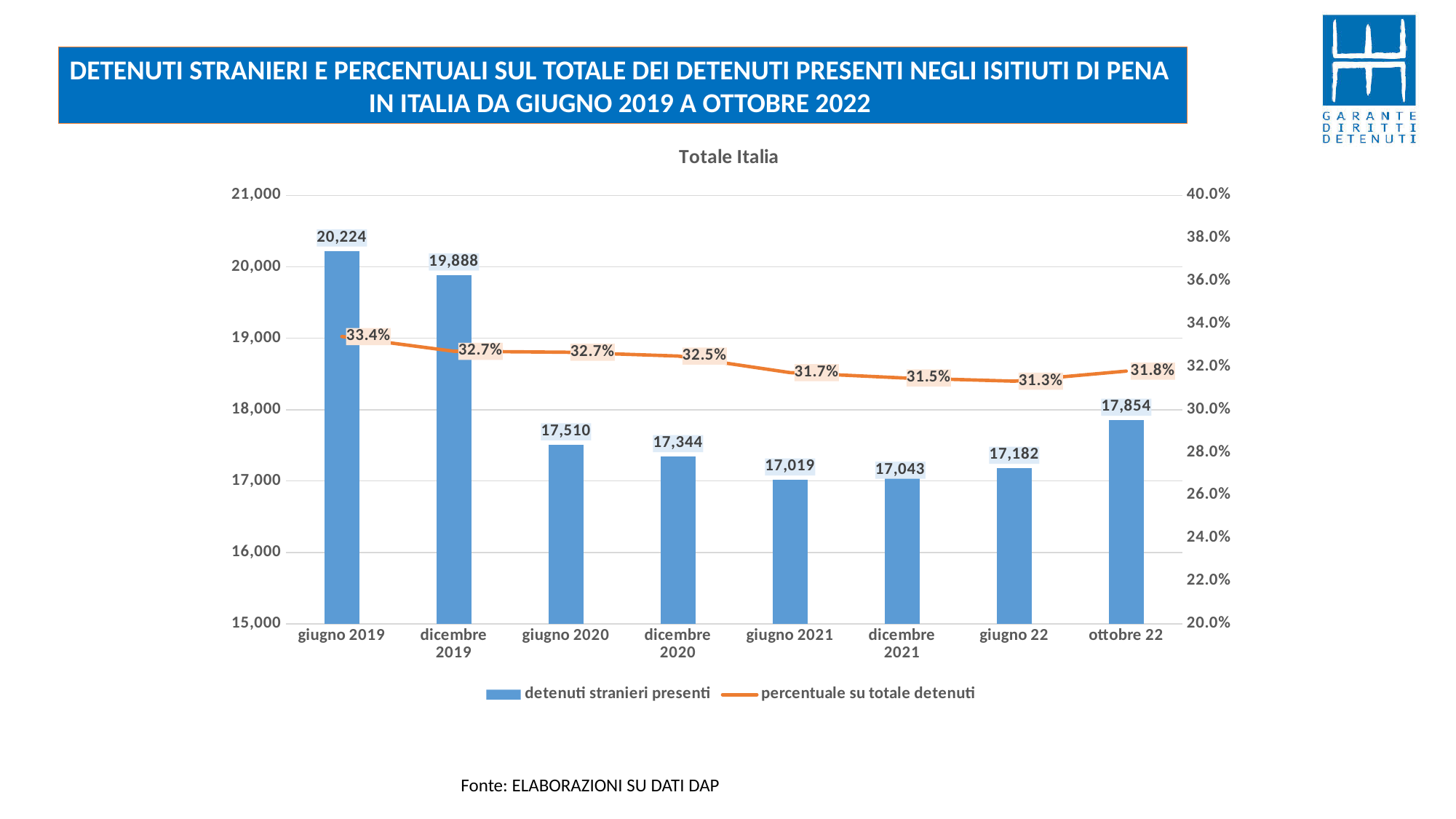
What is the value of 'detenuti stranieri presenti' for giugno 2019? 20,224 How many series does the legend list? 2 Which category has the lowest 'percentuale su totale detenuti'? giugno 22 What kind of chart is this? Combined bar and line chart Which category has the highest value of 'detenuti stranieri presenti'? giugno 2019 How many categories are shown on the x axis? 8 What is the value of 'detenuti stranieri presenti' for dicembre 2021? 17,043 Which is larger, the 'detenuti stranieri presenti' value for giugno 2020 or for ottobre 22? ottobre 22 Which category has the lowest value of 'detenuti stranieri presenti'? giugno 2021 What is the 'percentuale su totale detenuti' for ottobre 22? 31.8% What is the difference in 'detenuti stranieri presenti' between giugno 2019 and dicembre 2019? 336 What is the title of the chart? Totale Italia